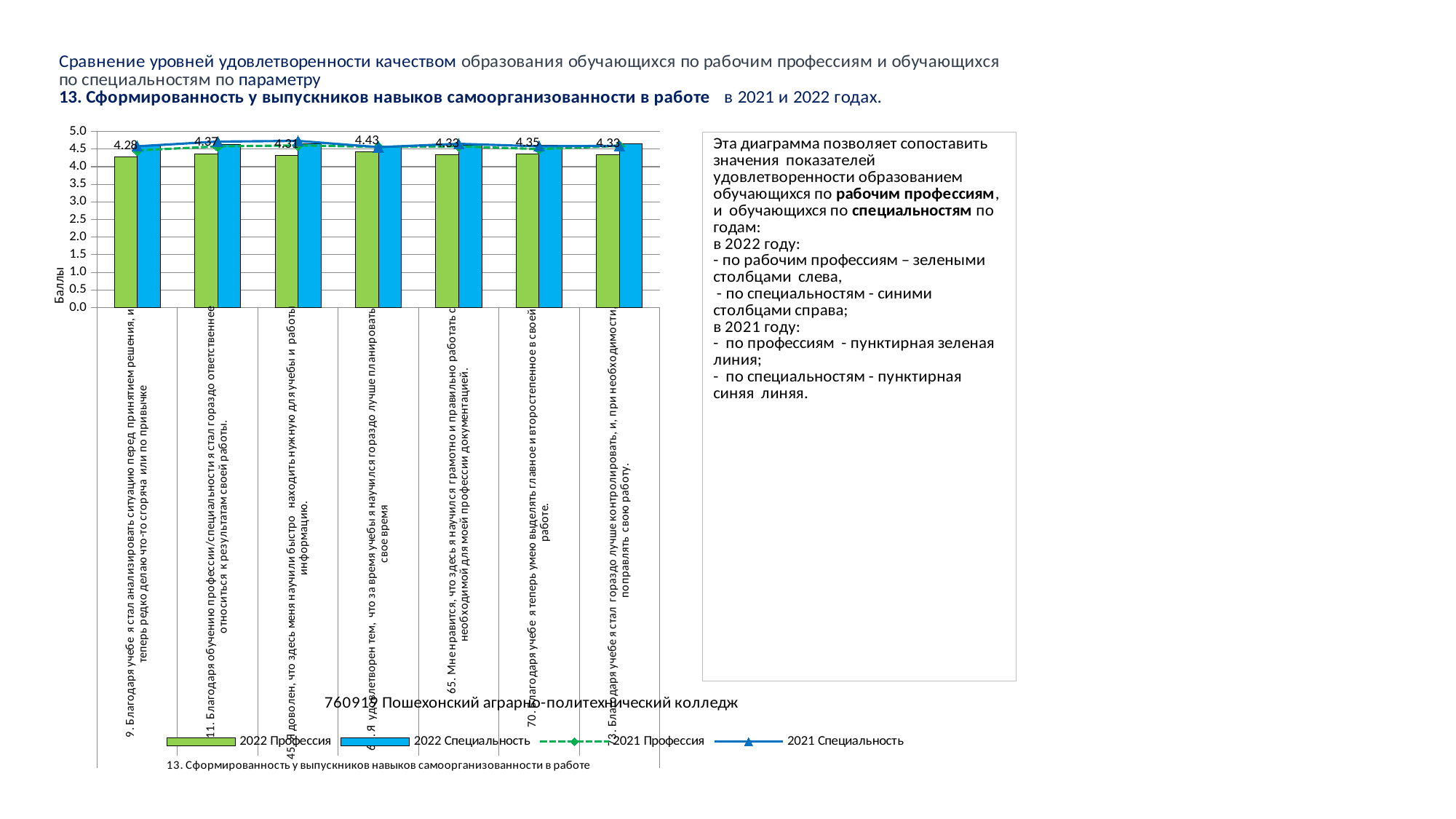
What data label is shown above the second category (item 11) in the chart? 4.37 What kind of chart is shown on the slide? combination bar and line chart What is the title of the vertical axis of the chart? Баллы For the first category (item 9), which bar is taller: the green 2022 Профессия bar or the blue 2022 Специальность bar? the blue 2022 Специальность bar Which category has the highest printed data label in the chart? the fourth category (научился гораздо лучше планировать свое время), 4.43 What data label is shown above the sixth category (item 70) in the chart? 4.35 How many series does the chart legend list? 4 What is the difference between the highest printed data label (4.43) and the lowest (4.28)? 0.15 Which category has the lowest printed data label in the chart? the first category (item 9), 4.28 What data label is shown above the first category (item 9) in the chart? 4.28 For the first category (item 9), is the blue 2022 Специальность bar greater or less than 4.0? greater How many categories are plotted along the x axis of the chart? 7